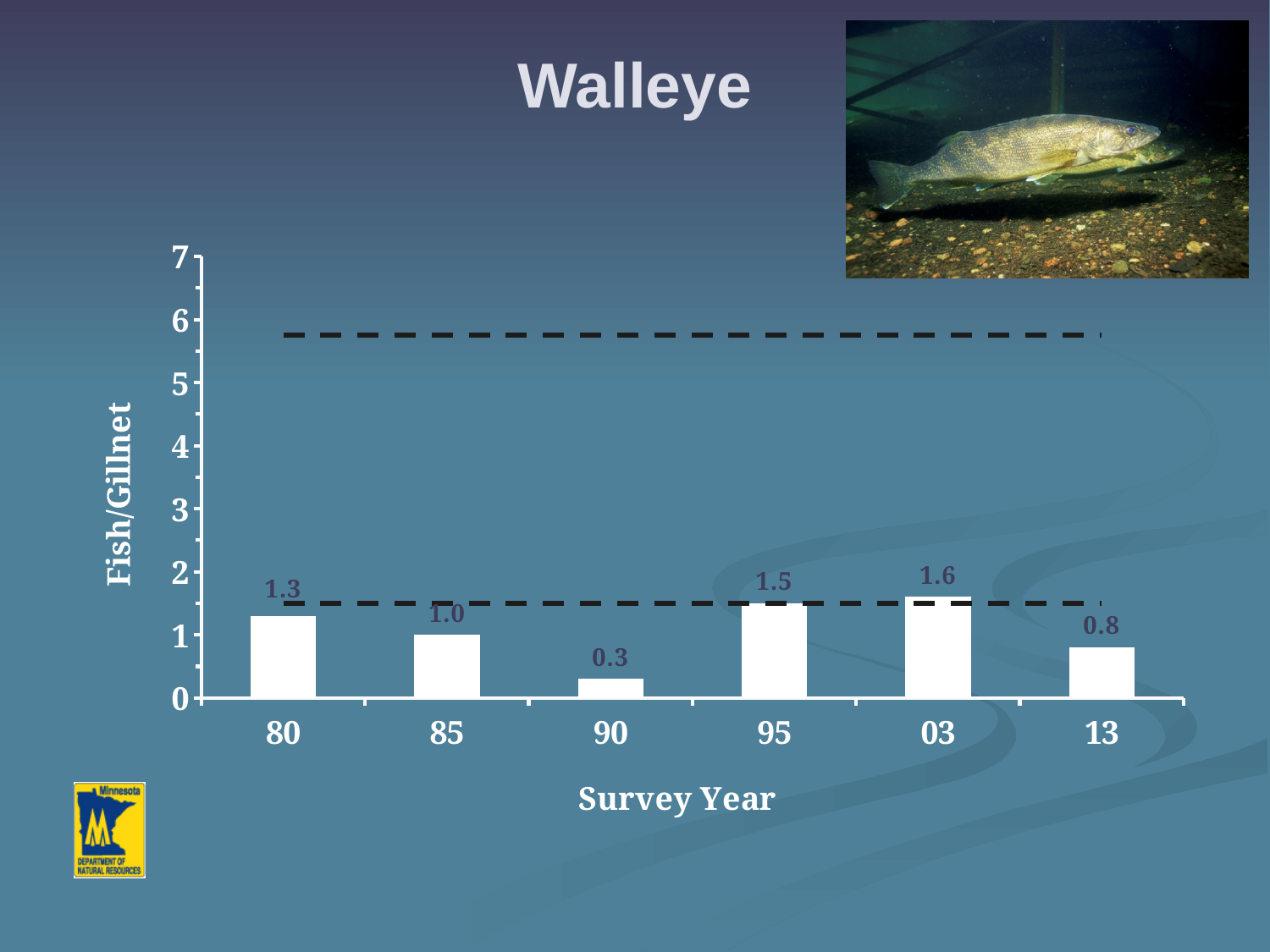
What is the Fish/Gillnet value for survey year 90? 0.3 What kind of chart is shown on the slide? bar chart What is the Fish/Gillnet value for survey year 13? 0.8 Which survey year has a larger Fish/Gillnet value, 85 or 95? 95 Which survey year has the highest Fish/Gillnet value? 03 What is the difference between the Fish/Gillnet values for survey years 03 and 90? 1.3 Which survey year has the lowest Fish/Gillnet value? 90 Is the value for survey year 95 greater or less than 1? greater What is the label of the y axis? Fish/Gillnet What is the Fish/Gillnet value for survey year 80? 1.3 How many survey years are shown on the x axis? 6 What is the title of the slide containing the chart? Walleye